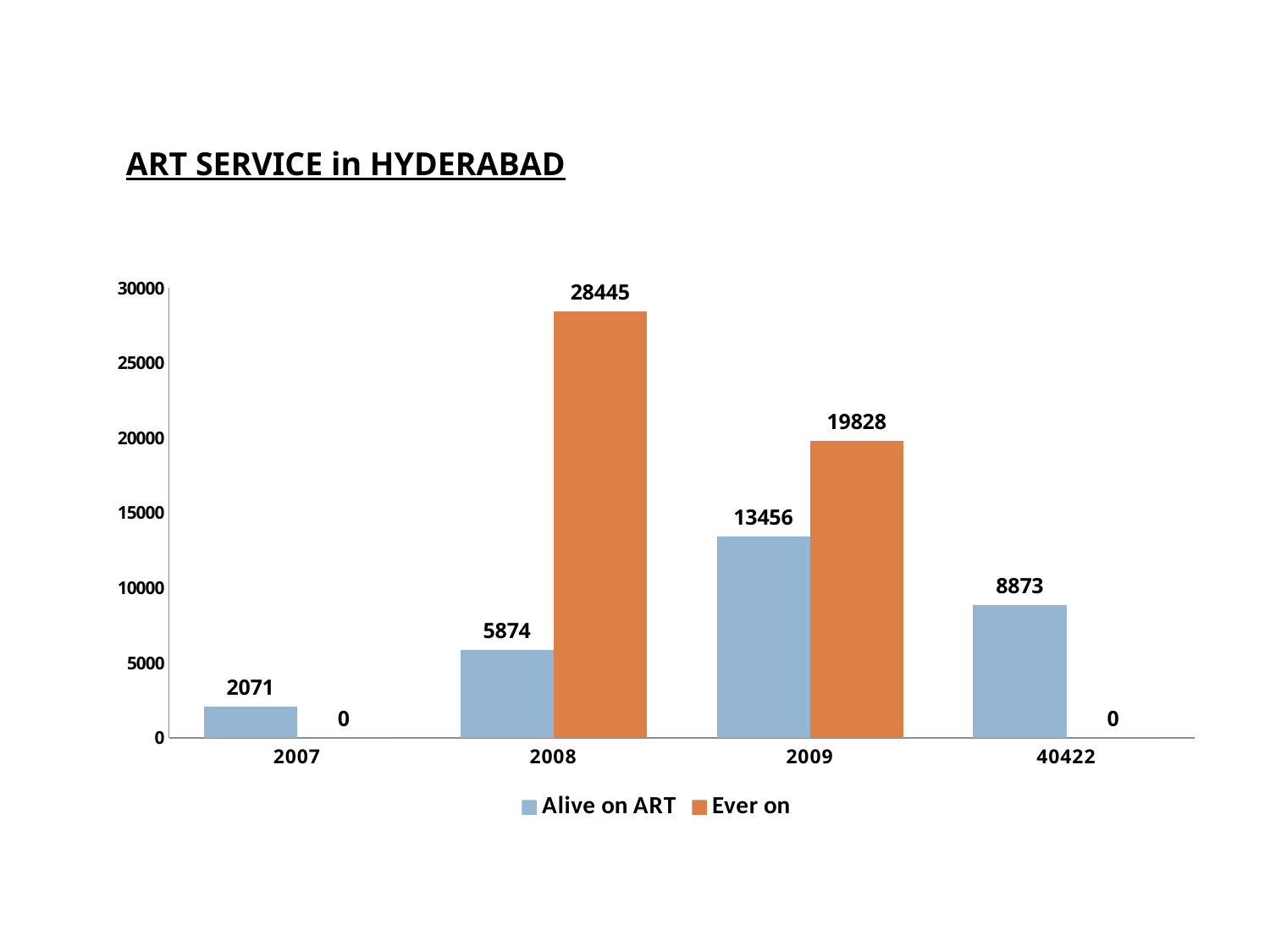
What is the value for Ever on in 2009? 19828 What is the value for Alive on ART in 2008? 5874 Which is larger in 2009, Alive on ART or Ever on? Ever on Which category has the highest value for Alive on ART? 2009 How many series does the legend list? 2 What is the value for Alive on ART in the category labelled 40422? 8873 What kind of chart is shown on the slide? bar chart How many categories are shown on the x axis? 4 What is the value for Ever on in 2007? 0 Is the value for Ever on in 2008 greater or less than 25000? greater What is the difference between Ever on and Alive on ART in 2008? 22571 Which category has the lowest value for Alive on ART? 2007